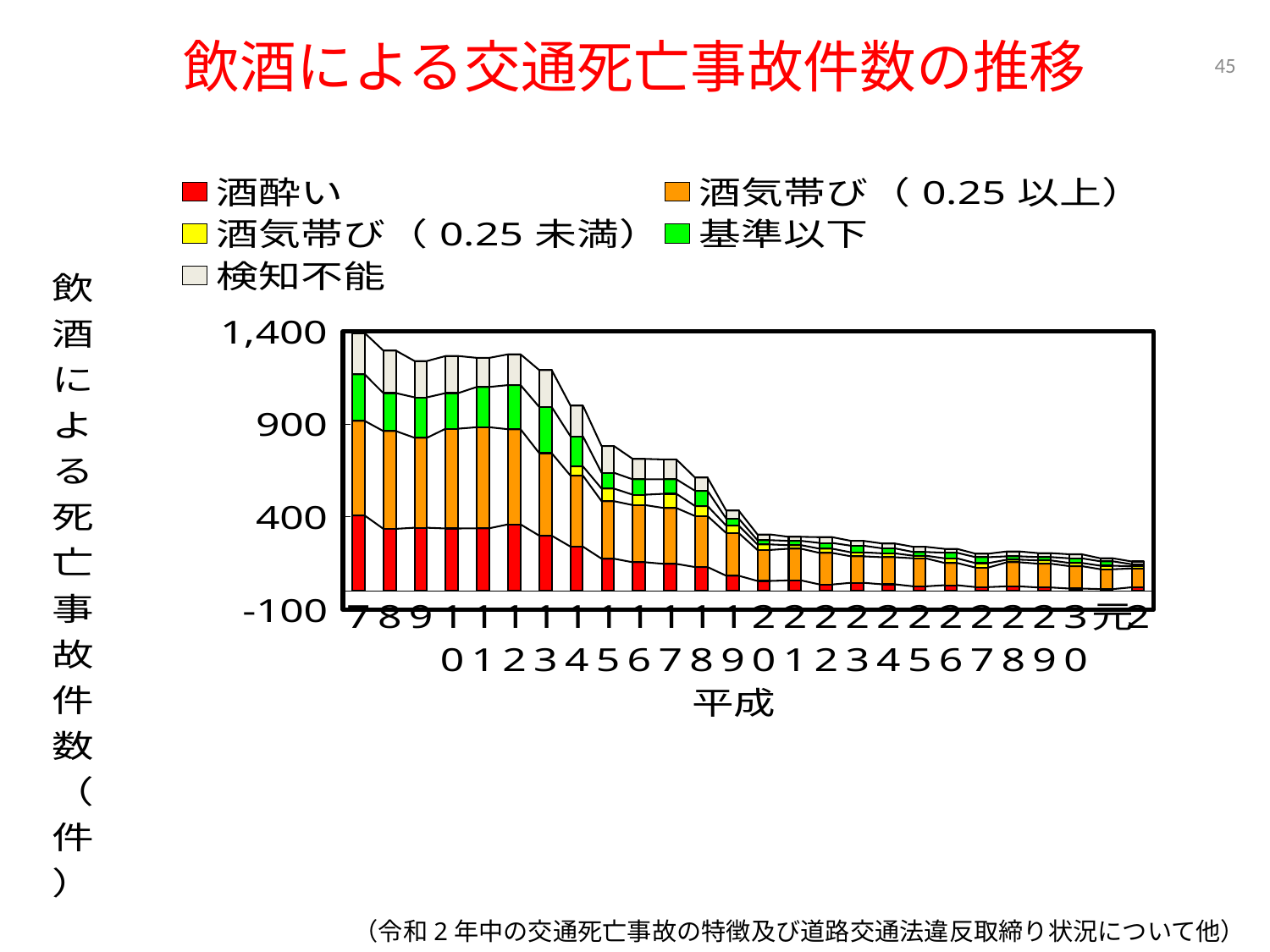
Which is larger, the total for 平成7 or the total for 令和2? 平成7 How many series does the legend list? 5 What is the title of the chart? 飲酒による交通死亡事故件数の推移 What kind of chart is shown on the slide? stacked bar chart Is the total for 平成10 greater or less than 900? greater Which series is shown in red in the legend? 酒酔い Do the total bar heights generally rise or fall from 平成7 to 令和2? fall Which is larger, the total for 平成15 or the total for 平成20? 平成15 Which year has the highest total bar? 平成7 Is the total for 平成7 greater or less than 900? greater Is the total for 平成25 greater or less than 400? less